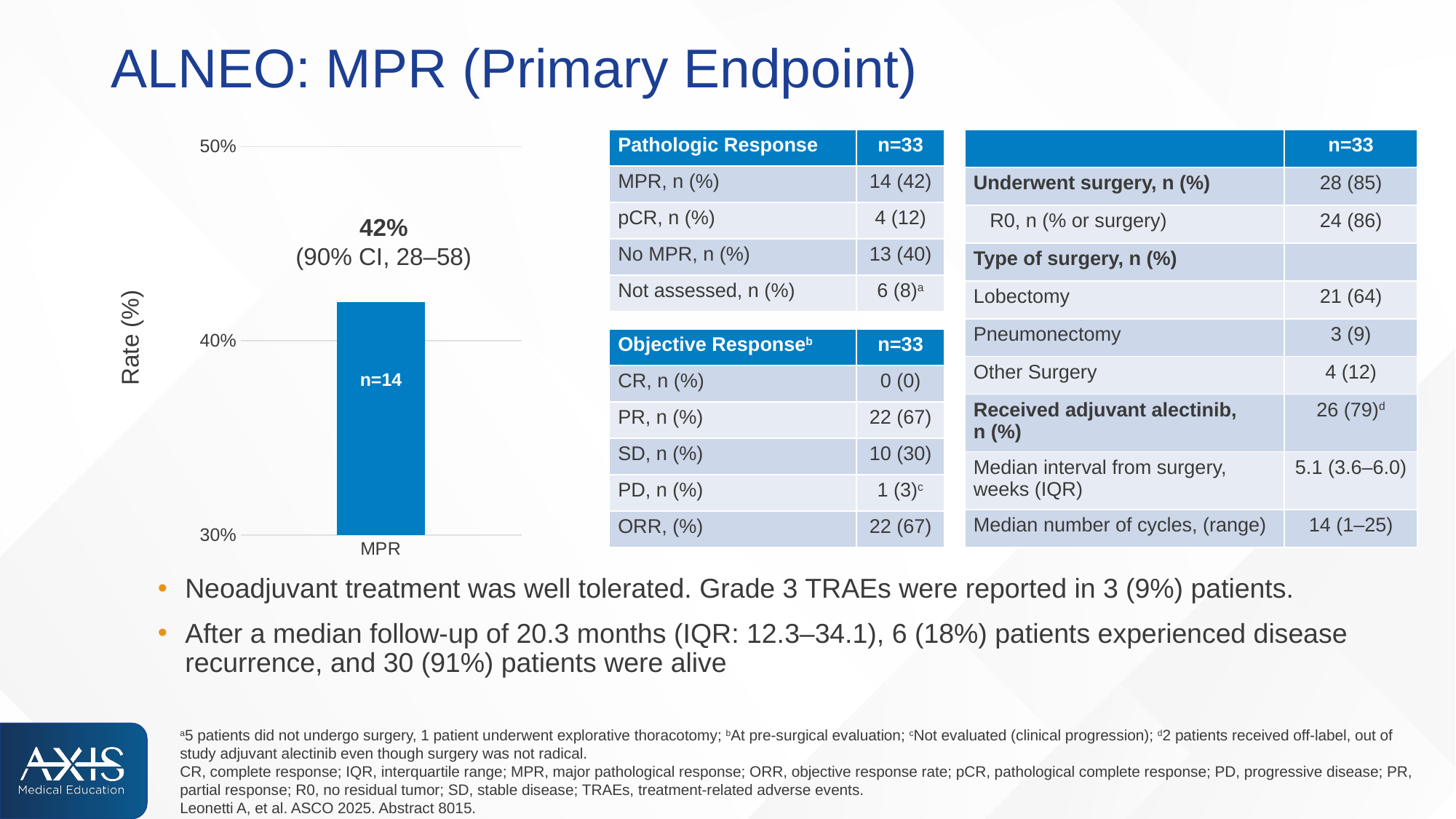
How many categories are plotted in the chart? 1 What is the 90% confidence interval printed above the MPR bar? 28–58 How many patients does the label inside the MPR bar indicate? n=14 Is the value for MPR greater or less than 40%? greater What is the MPR rate shown by the bar in the chart? 42% What is the category label on the x axis of the chart? MPR What kind of chart is shown on the left of the slide? bar chart Is the value for MPR greater or less than 50%? less What is the label of the y axis of the chart? Rate (%)